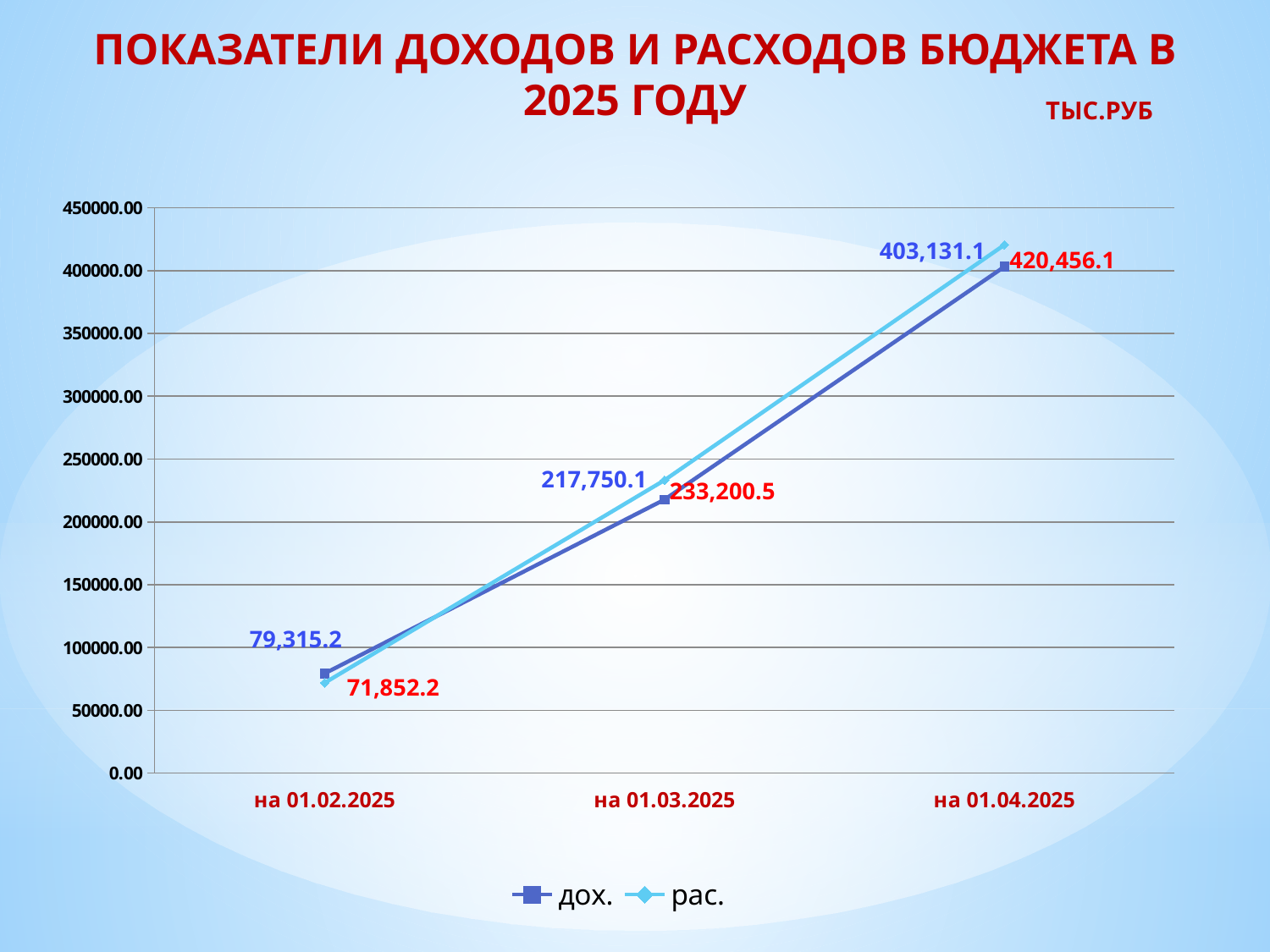
At which date does the рас. series reach its highest value? на 01.04.2025 How many series does the legend list? 2 What is the difference between рас. and дох. at на 01.04.2025? 17,325.0 What is the value of the дох. series at на 01.02.2025? 79,315.2 At which date is the дох. series lowest? на 01.02.2025 Which series has the larger value at на 01.02.2025, дох. or рас.? дох. Which series has the larger value at на 01.03.2025, дох. or рас.? рас. What is the value of the дох. series at на 01.03.2025? 217,750.1 Do the values of the дох. series rise or fall from на 01.02.2025 to на 01.04.2025? rise What is the value of the рас. series at на 01.04.2025? 420,456.1 What is the value of the рас. series at на 01.02.2025? 71,852.2 How many dates are plotted on the x axis? 3